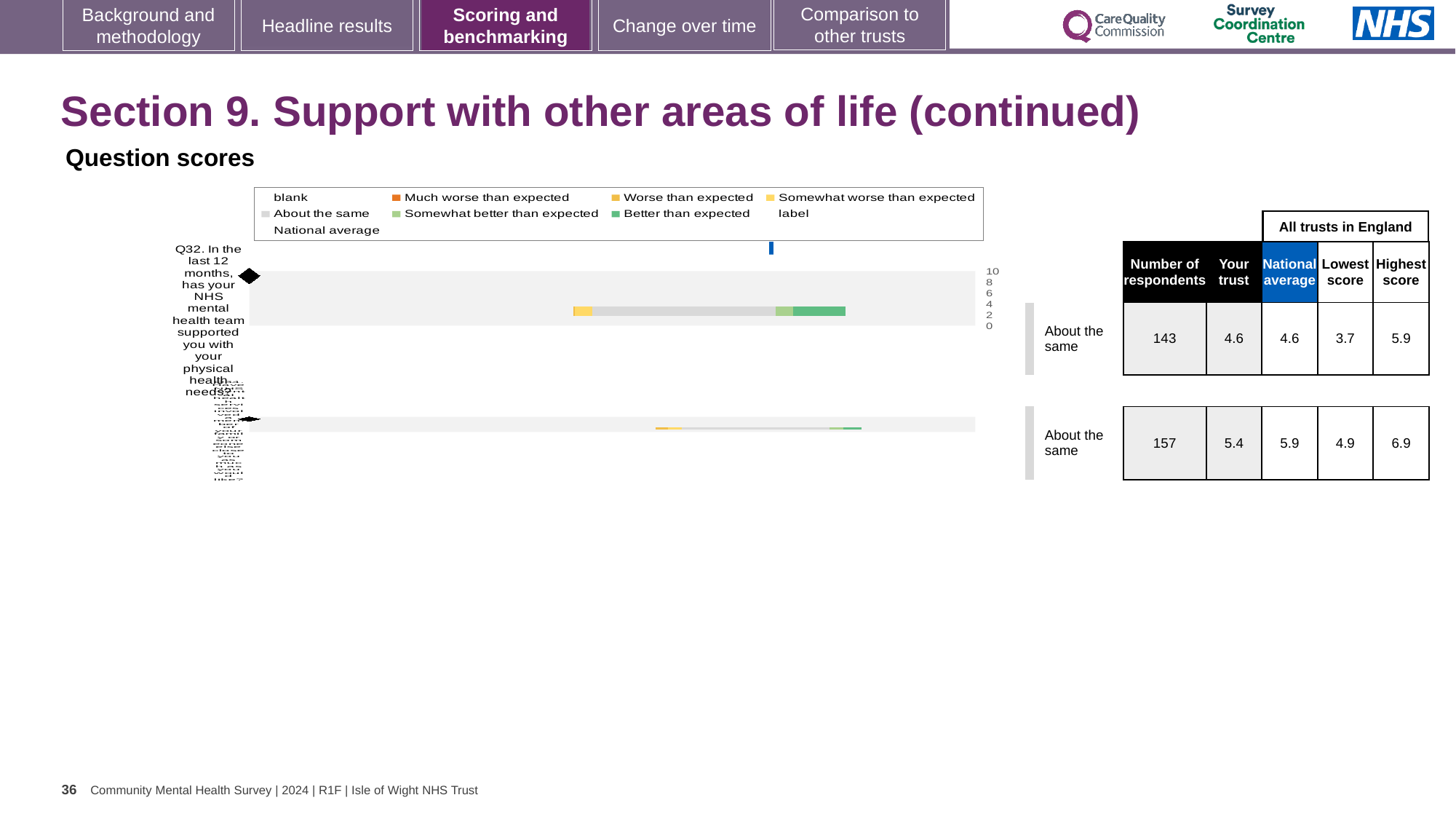
What benchmark category is shown for Q32? About the same What is the difference between the highest and lowest scores for Q32? 2.2 What is the highest score among all trusts in England for Q32? 5.9 How many entries does the chart legend list? 9 What is the lowest score among all trusts in England for Q32? 3.7 What is the number of respondents for Q32 in the table? 143 What kind of chart is used to show the question scores on this slide? bar chart Is the trust's score for Q32 higher than, lower than, or equal to the national average? equal How many question rows are plotted in the chart? 2 What is the national average score for Q32? 4.6 What is the number of respondents shown in the second row of the table? 157 What is the 'Your trust' score for Q32? 4.6